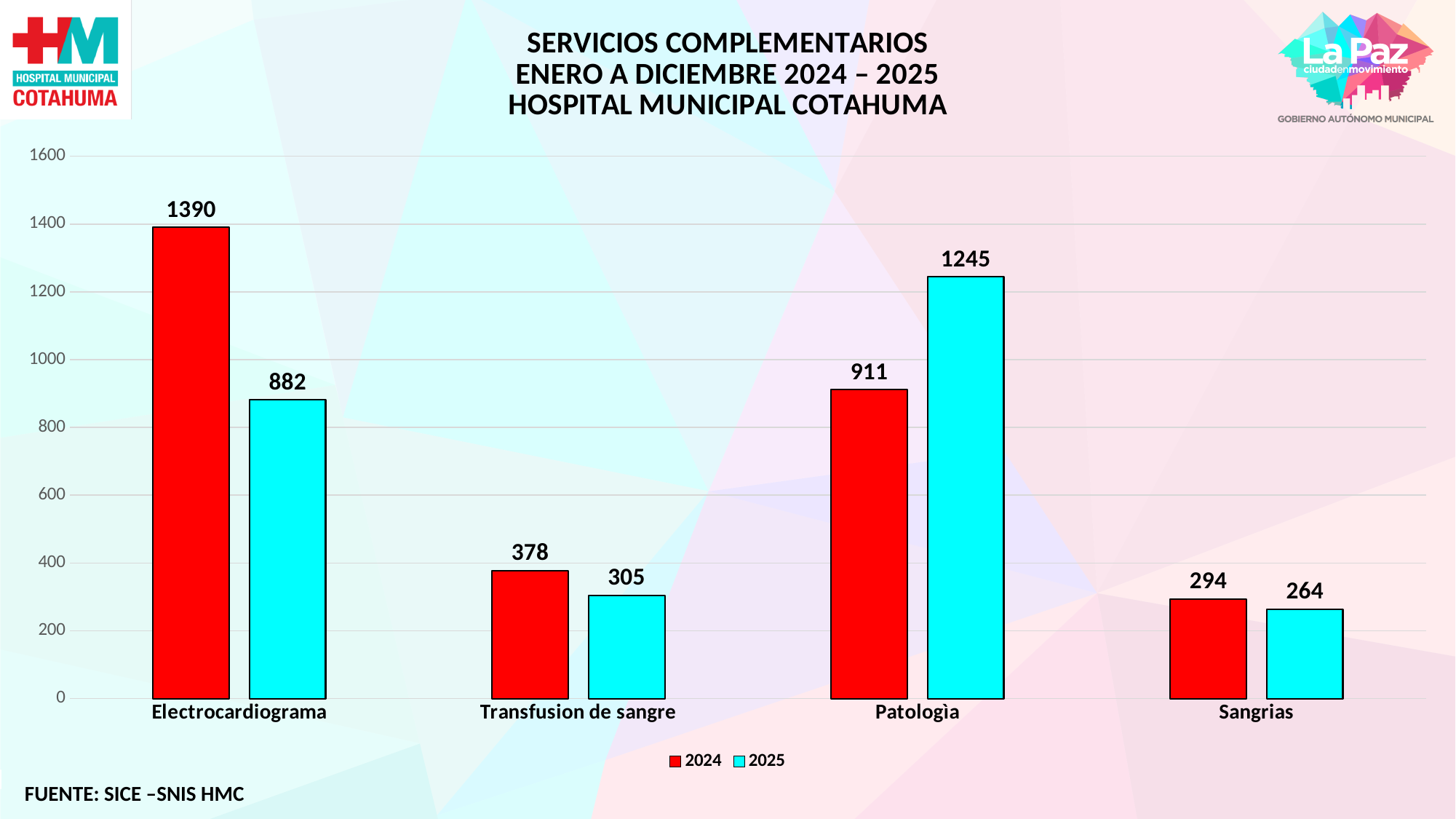
What is the 2024 value for Electrocardiograma? 1390 Which category has the lowest 2025 value? Sangrias How many series does the legend list? 2 What is the 2025 value for Patologìa? 1245 What is the difference between the 2025 and 2024 values for Patologìa? 334 What is the difference between the 2024 and 2025 values for Electrocardiograma? 508 Which is larger for Patologìa, the 2024 value or the 2025 value? 2025 What kind of chart is shown on the slide? Bar chart What is the 2024 value for Sangrias? 294 What is the 2025 value for Transfusion de sangre? 305 Which category has the highest 2024 value? Electrocardiograma How many categories are shown on the x axis? 4